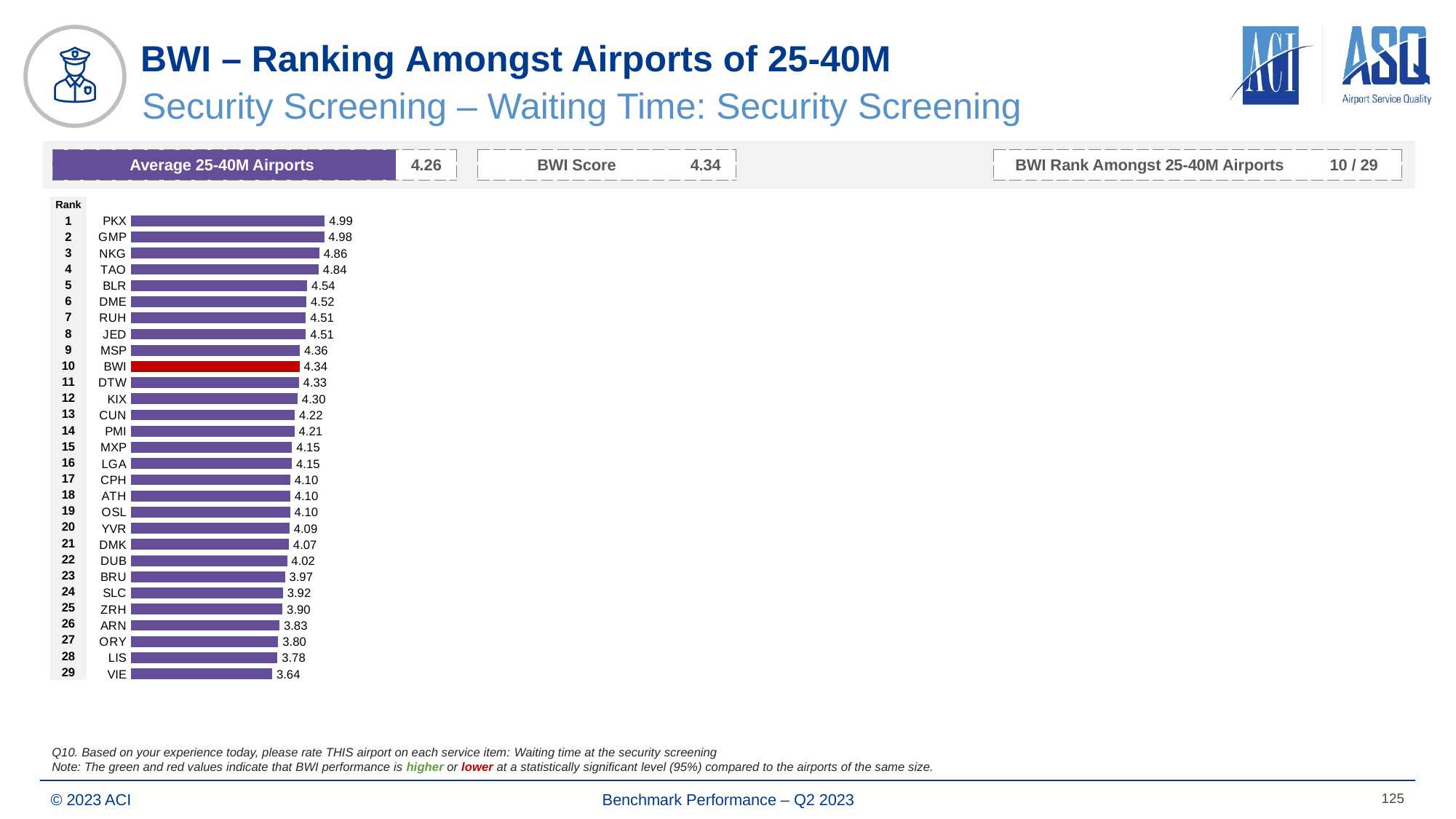
What is the value for BWI in the chart? 4.34 Which bar in the chart is coloured red? BWI What is the difference between the values for BWI and DTW? 0.01 How many airports are ranked in the chart? 29 What kind of chart is shown on the slide? Bar chart Which airport has the lowest value in the chart? VIE What is the value for VIE in the chart? 3.64 What is the value for PKX in the chart? 4.99 What is the difference between the values for PKX and VIE? 1.35 Which has a larger value, MSP or CUN? MSP What is the value for LIS in the chart? 3.78 Which airport has the highest value in the chart? PKX